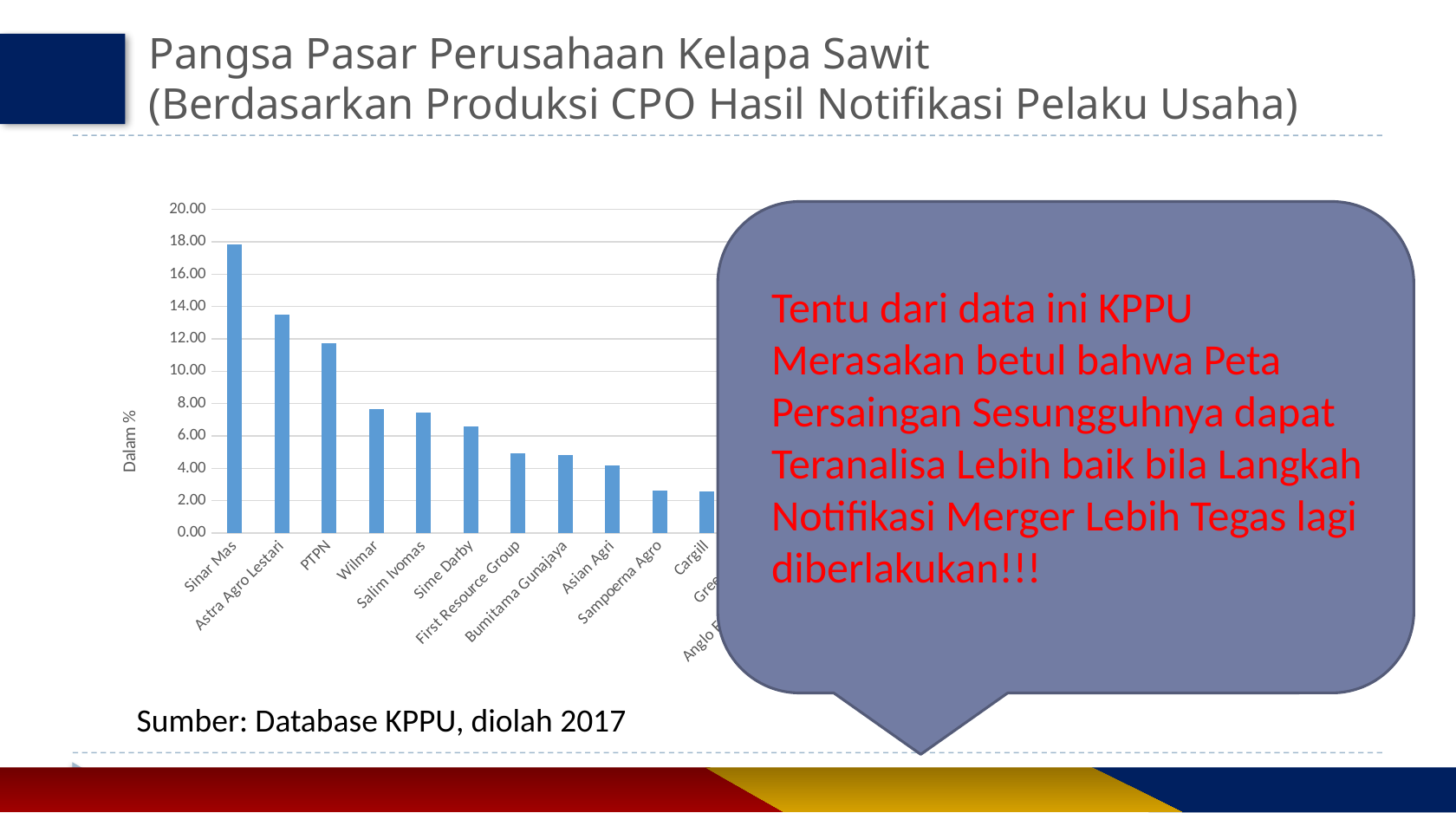
Is the value for Wilmar greater or less than 6.00? greater Is the value for Sinar Mas greater or less than 16.00? greater What kind of chart is shown on the slide? bar chart Is the value for Asian Agri greater or less than 6.00? less Do the bar values rise or fall moving from left to right along the x axis? fall What is the label on the vertical axis of the chart? Dalam % Which is larger, the value for Sime Darby or the value for Asian Agri? Sime Darby Which is larger, the value for Sinar Mas or the value for Astra Agro Lestari? Sinar Mas Which company has the highest market share in the chart? Sinar Mas